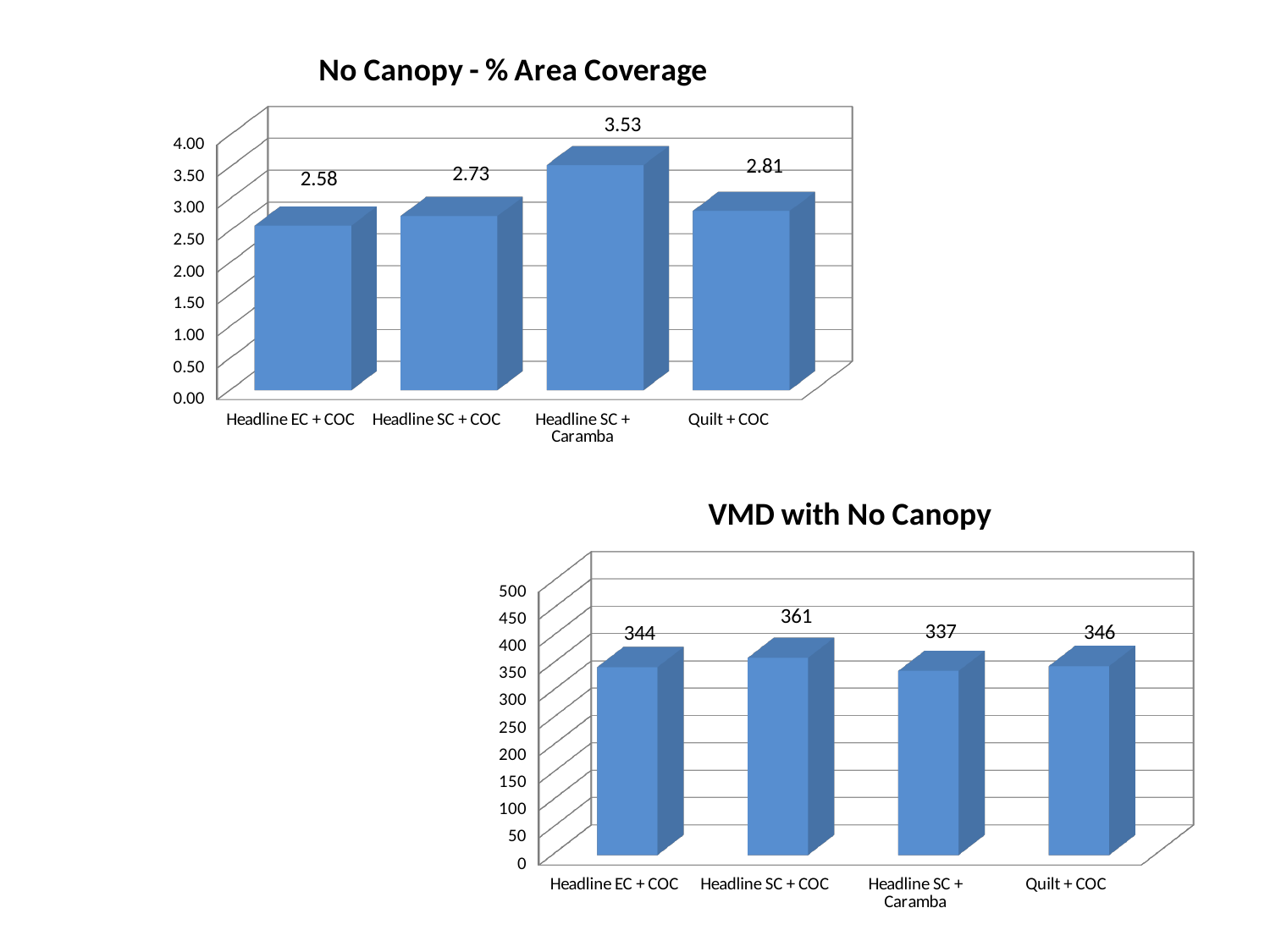
In the 'No Canopy - % Area Coverage' chart, what is the difference between Headline SC + Caramba and Quilt + COC? 0.72 In the 'VMD with No Canopy' chart, is the value for Headline EC + COC greater or less than 300? greater In the 'VMD with No Canopy' chart, what is the difference between Headline SC + COC and Headline SC + Caramba? 24 In the 'VMD with No Canopy' chart, what is the value for Headline SC + COC? 361 What kind of chart is 'VMD with No Canopy'? Bar chart In the 'No Canopy - % Area Coverage' chart, which category has the highest value? Headline SC + Caramba In the 'No Canopy - % Area Coverage' chart, how many categories are shown? 4 In the 'VMD with No Canopy' chart, which category has the lowest value? Headline SC + Caramba In the 'VMD with No Canopy' chart, what is the value for Quilt + COC? 346 In the 'No Canopy - % Area Coverage' chart, what is the value for Headline EC + COC? 2.58 In the 'No Canopy - % Area Coverage' chart, what is the value for Headline SC + Caramba? 3.53 In the 'No Canopy - % Area Coverage' chart, which category has the lowest value? Headline EC + COC